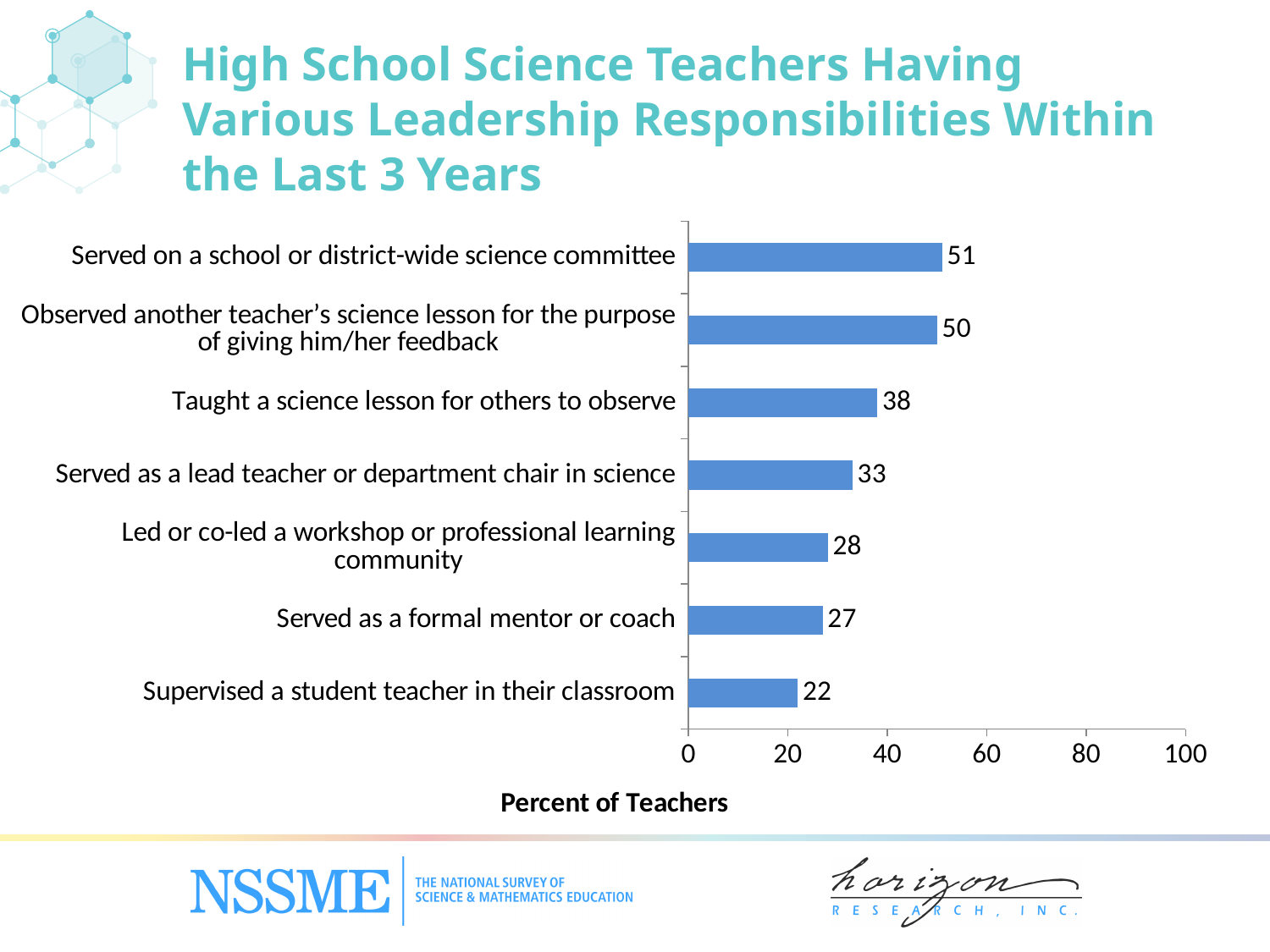
Which leadership responsibility has the highest percent of teachers? Served on a school or district-wide science committee What percent of teachers supervised a student teacher in their classroom? 22 Is the value for 'Served as a lead teacher or department chair in science' greater or less than 40? less What kind of chart is shown on the slide? Bar chart Which is larger: the percent who led or co-led a workshop or professional learning community, or the percent who supervised a student teacher in their classroom? Led or co-led a workshop or professional learning community What percent of high school science teachers served on a school or district-wide science committee? 51 What is the difference in percent between teachers who taught a science lesson for others to observe and those who served as a lead teacher or department chair in science? 5 What is the label of the horizontal axis? Percent of Teachers What percent of teachers served as a formal mentor or coach? 27 How many leadership responsibilities are shown in the chart? 7 Which leadership responsibility has the lowest percent of teachers? Supervised a student teacher in their classroom What percent of teachers taught a science lesson for others to observe? 38